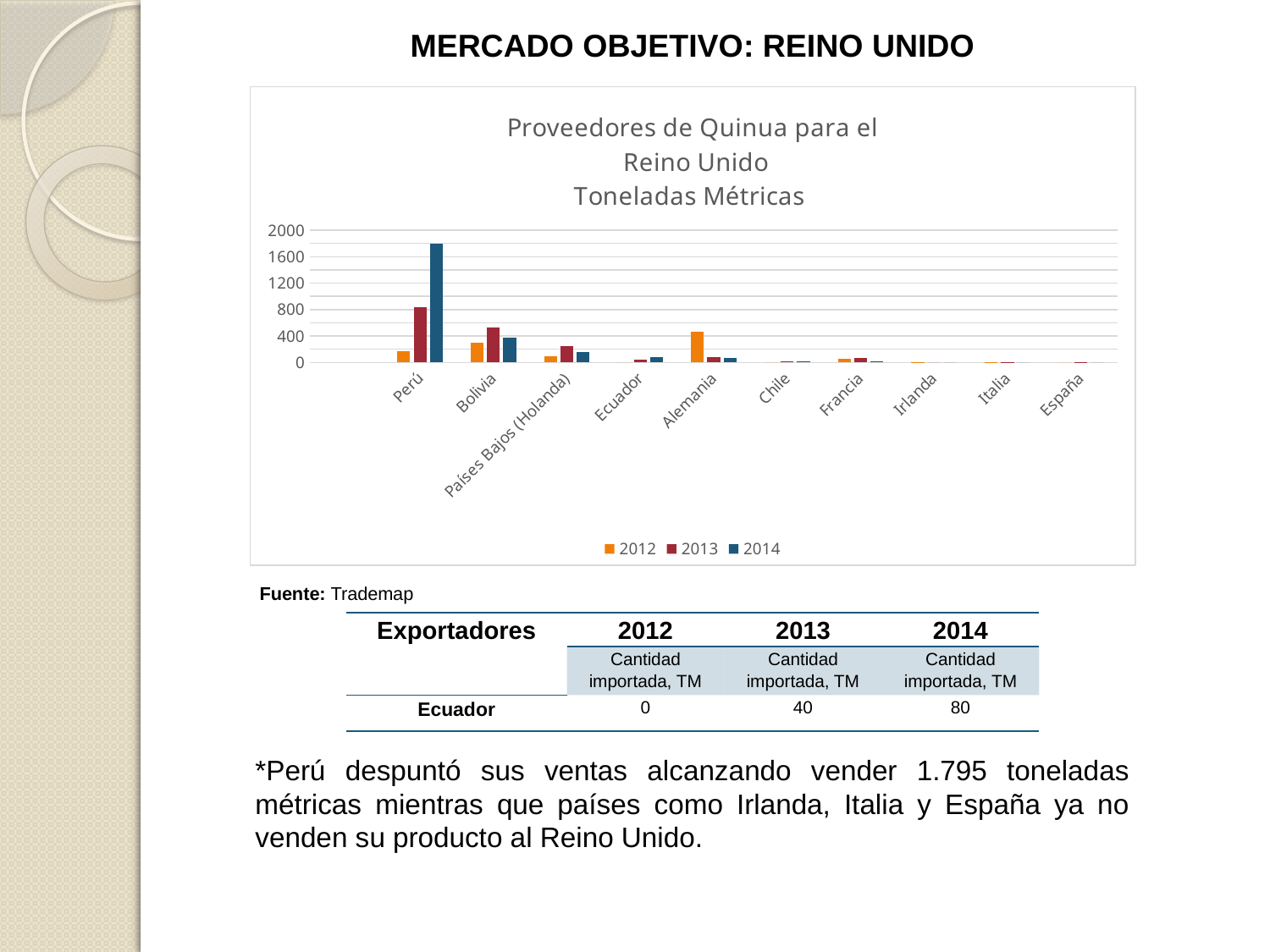
Is the 2012 value for Alemania greater or less than 800? less What kind of chart is shown on the slide? bar chart Is the 2012 value for Perú greater or less than 400? less Which years are listed in the chart legend? 2012, 2013, 2014 Which country has the tallest bar in the chart? Perú Do the values for Perú rise or fall from 2012 to 2014? rise Which is larger, the 2014 value for Perú or the 2014 value for Bolivia? Perú Is the 2014 value for Perú greater or less than 1600? greater According to the table below the chart, what was the quantity imported from Ecuador in 2014? 80 How many series does the chart legend list? 3 How many countries are shown on the x axis of the chart? 10